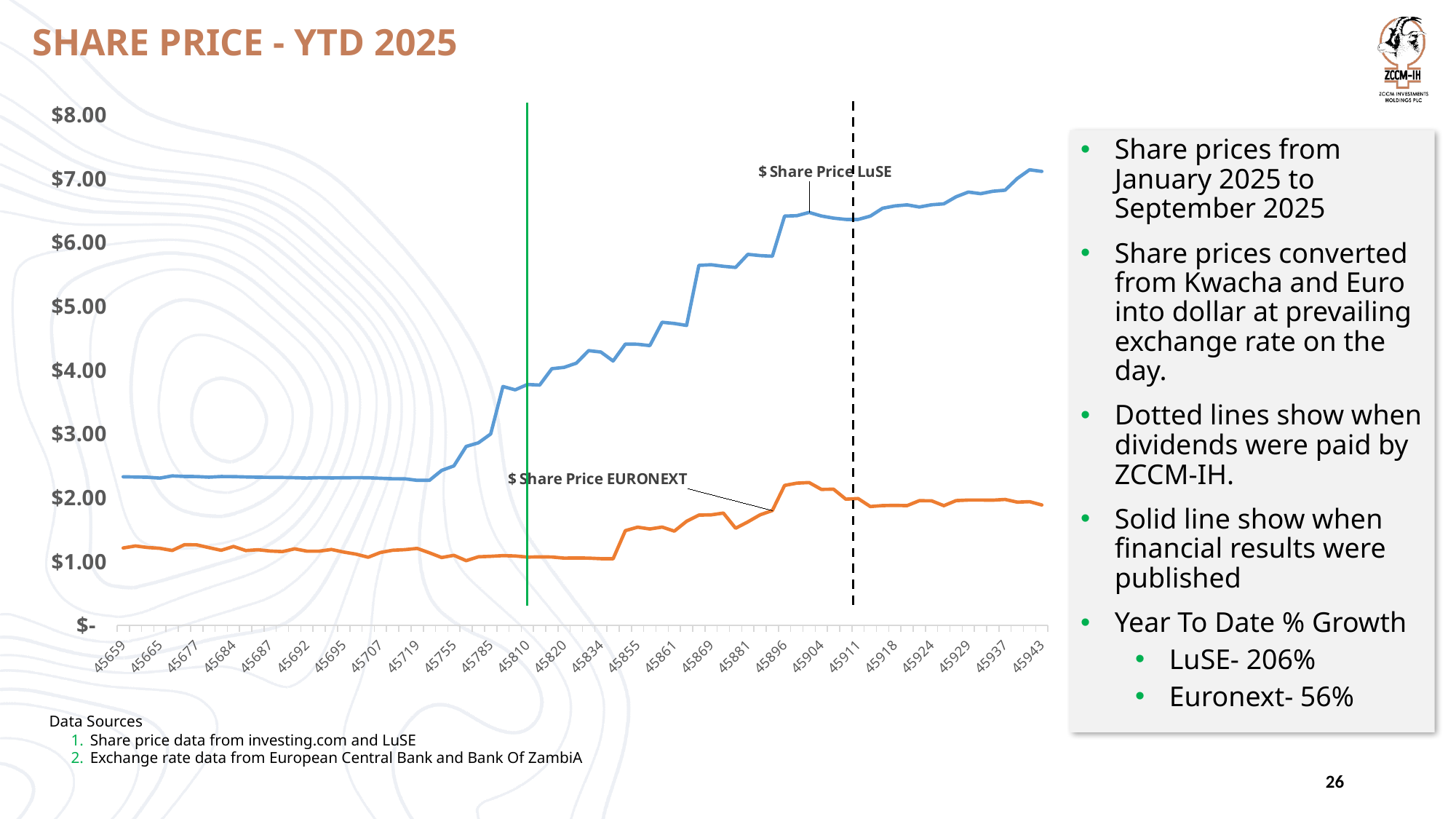
Which series is higher at 45943, $ Share Price LuSE or $ Share Price EURONEXT? $ Share Price LuSE What are the names of the two series plotted on the chart? $ Share Price LuSE and $ Share Price EURONEXT Does the $ Share Price LuSE line rise or fall overall from left to right along the x axis? rise Is the value for $ Share Price EURONEXT at 45659 greater or less than $2.00? less Is the value for $ Share Price LuSE at 45810 greater or less than $3.00? greater Is the value for $ Share Price LuSE at 45659 greater or less than $3.00? less Which series reaches the highest value on the chart? $ Share Price LuSE What kind of chart is shown on the slide? line chart What is the title of the chart on the slide? SHARE PRICE - YTD 2025 Does the $ Share Price EURONEXT line rise or fall overall from 45659 to 45943? rise How many series are plotted on the chart? 2